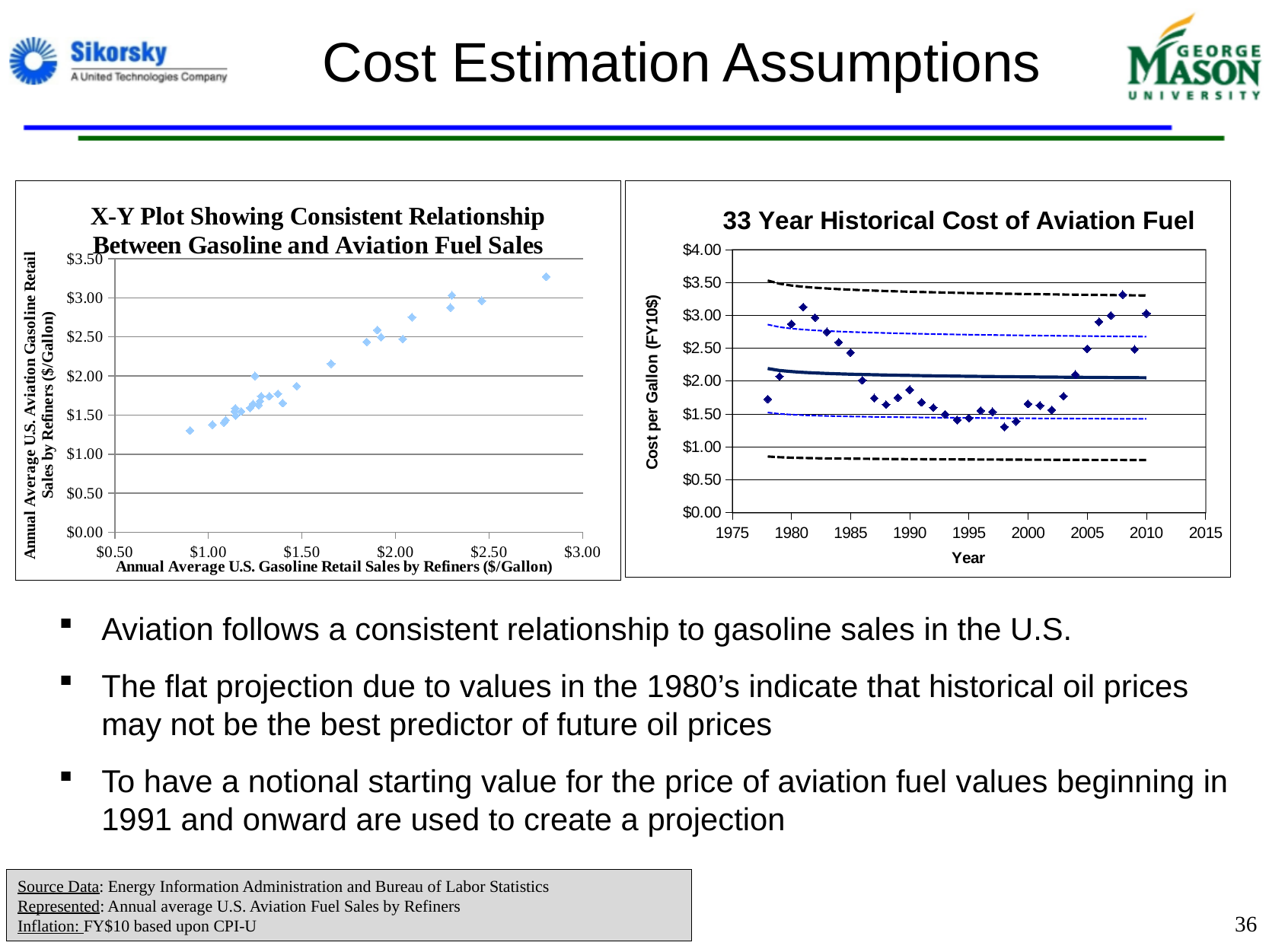
In the right chart '33 Year Historical Cost of Aviation Fuel', is the cost per gallon for 1998 greater or less than $1.50? less In the left X-Y plot, do the aviation fuel values rise or fall as gasoline retail sales increase along the x axis? Rise In the right chart '33 Year Historical Cost of Aviation Fuel', which year has the lowest plotted cost per gallon? 1998 In the right chart '33 Year Historical Cost of Aviation Fuel', which year has a higher cost per gallon, 1981 or 1990? 1981 In the right chart '33 Year Historical Cost of Aviation Fuel', is the cost per gallon for 2008 greater or less than $3.00? greater In the right chart '33 Year Historical Cost of Aviation Fuel', is the cost per gallon for 2006 greater or less than $3.00? less What kind of chart is the left chart titled 'X-Y Plot Showing Consistent Relationship Between Gasoline and Aviation Fuel Sales'? Scatter plot What is the title of the right chart? 33 Year Historical Cost of Aviation Fuel In the right chart '33 Year Historical Cost of Aviation Fuel', which year has a higher cost per gallon, 2008 or 1998? 2008 What is the x-axis label of the left X-Y plot? Annual Average U.S. Gasoline Retail Sales by Refiners ($/Gallon)